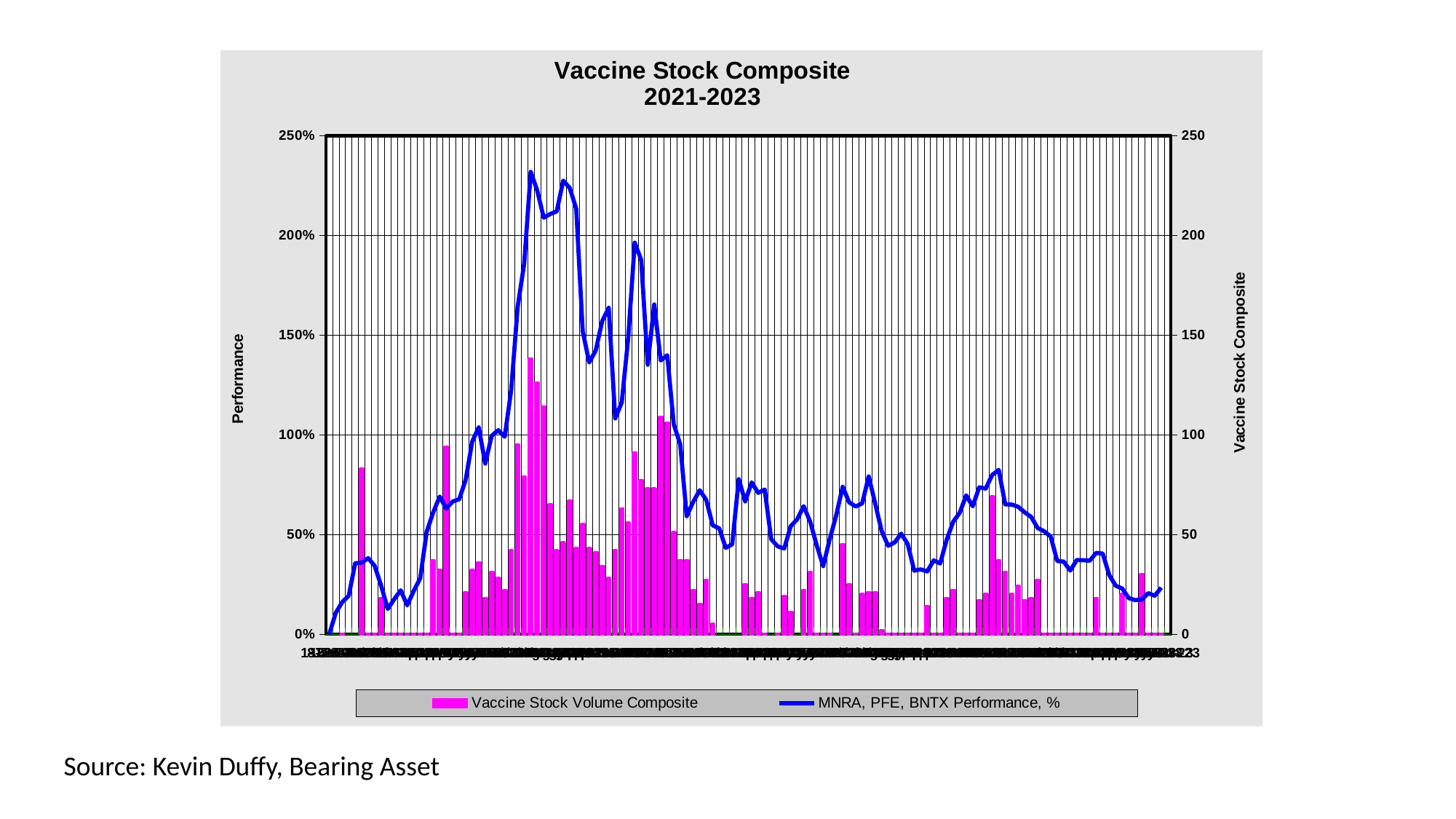
What kind of chart is this? Combined bar and line chart Is the tallest Vaccine Stock Volume Composite bar greater or less than 150 on the right axis? less Is the tallest Vaccine Stock Volume Composite bar greater or less than 100 on the right axis? greater What is the title of the chart? Vaccine Stock Composite 2021-2023 What is the maximum value shown on the left Performance axis? 250% Is the value of the MNRA, PFE, BNTX Performance line at the far left start of the chart greater or less than 50%? less Which series is drawn as magenta bars? Vaccine Stock Volume Composite Does the MNRA, PFE, BNTX Performance line end higher or lower than its peak in the first half of the chart? lower How many series does the legend list? 2